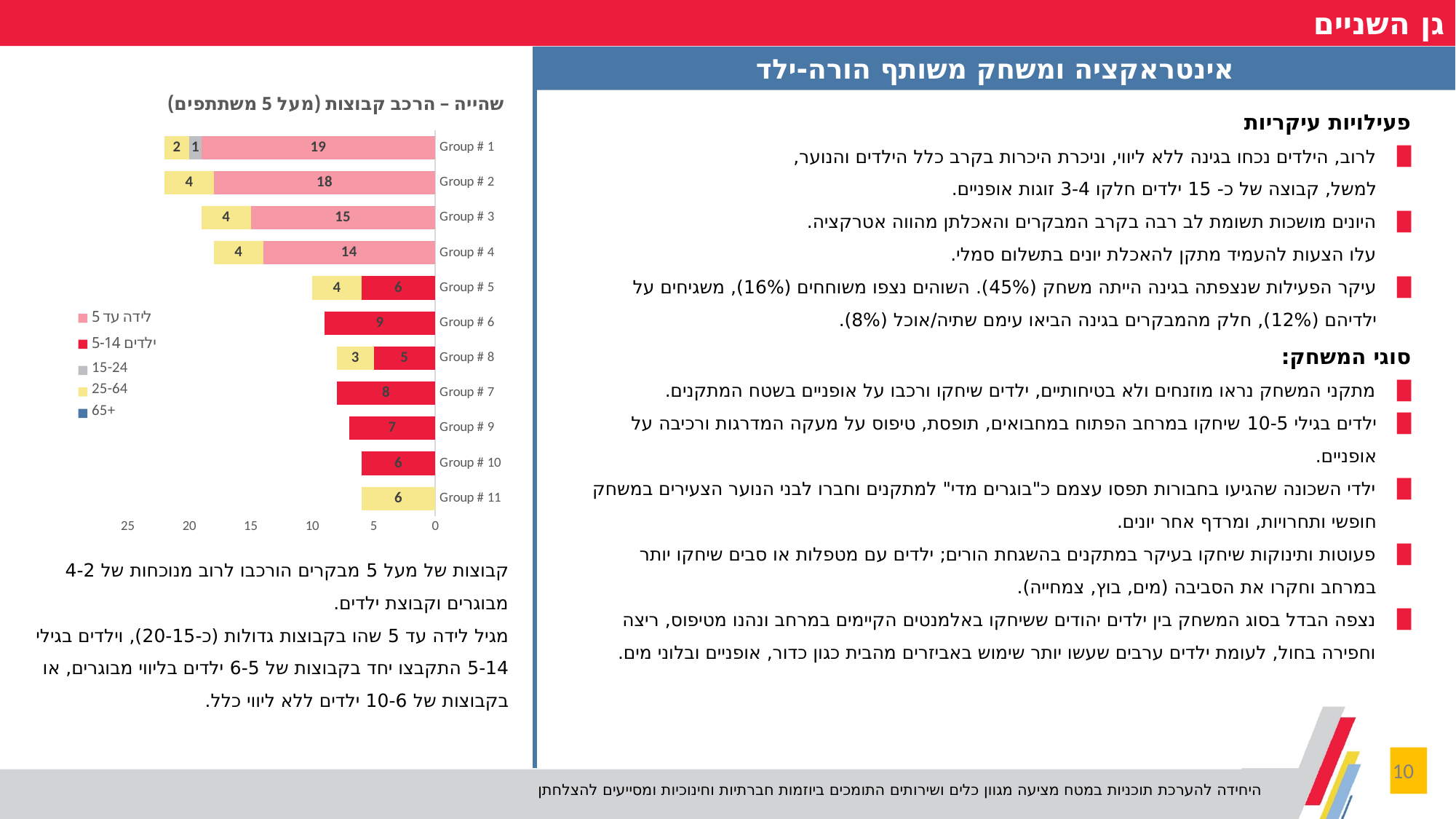
What is the value of the 'לידה עד 5' segment for Group # 1? 19 How many groups (categories) are plotted in the chart? 11 Which group has the lowest total bar value? Group # 10 and Group # 11 (tied at 6) What is the total of the stacked bar for Group # 5? 10 Which is larger: the '5-14 ילדים' value for Group # 7 or for Group # 10? Group # 7 How many series does the chart legend list? 5 What is the value of the '15-24' segment for Group # 1? 1 What is the total of the stacked bar for Group # 3? 19 What is the value of the '5-14 ילדים' segment for Group # 6? 9 What type of chart is shown on the slide? stacked bar chart What is the value of the '25-64' segment for Group # 2? 4 What is the difference between the 'לידה עד 5' values of Group # 2 and Group # 4? 4